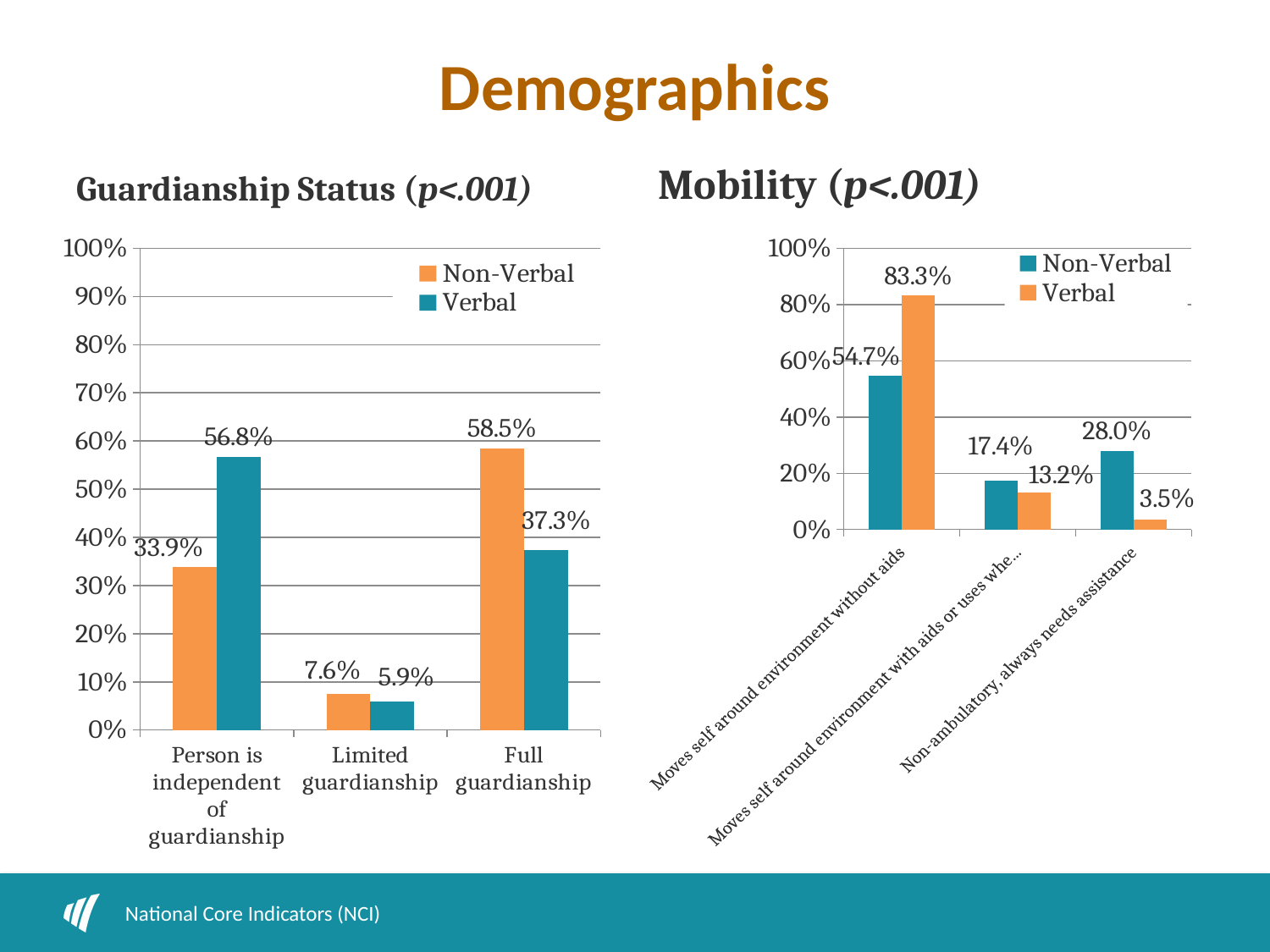
In the Guardianship Status chart, how many categories are shown on the x axis? 3 In the Guardianship Status chart, which category has the lowest Verbal value? Limited guardianship In the Mobility chart, what is the Verbal value for Moves self around environment without aids? 83.3% In the Guardianship Status chart, what is the difference between the Non-Verbal and Verbal values for Full guardianship? 21.2% In the Mobility chart, how many series does the legend list? 2 In the Guardianship Status chart, what is the Verbal value for Person is independent of guardianship? 56.8% In the Guardianship Status chart, what is the Non-Verbal value for Full guardianship? 58.5% In the Mobility chart, what is the Non-Verbal value for Non-ambulatory, always needs assistance? 28.0% In the Guardianship Status chart, is the Non-Verbal value for Person is independent of guardianship greater or less than 40%? less In the Mobility chart, which series has the higher value for Non-ambulatory, always needs assistance? Non-Verbal In the Mobility chart, what is the difference between the Verbal and Non-Verbal values for Moves self around environment without aids? 28.6% What type of chart is the Mobility chart? Bar chart